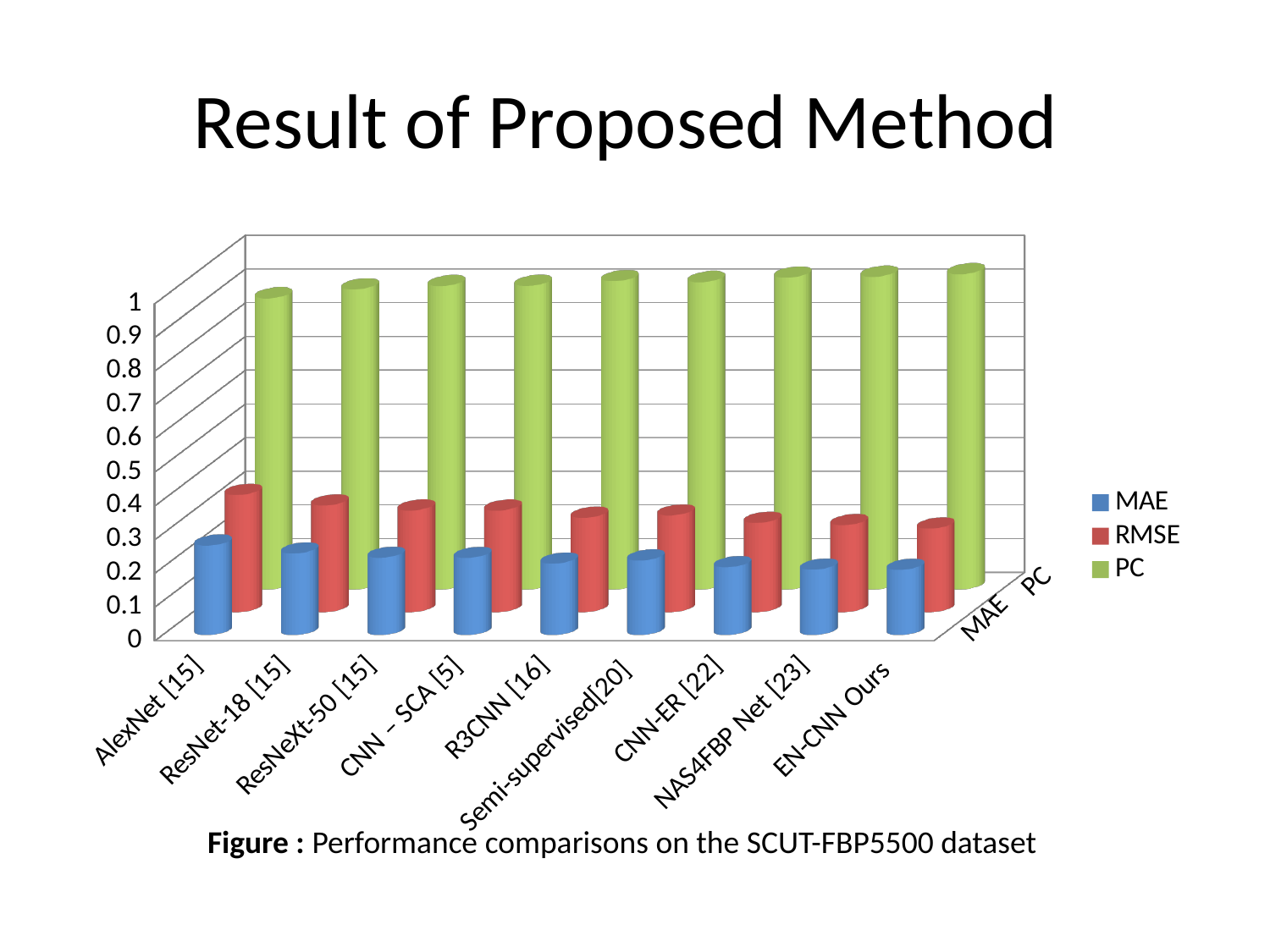
Is the MAE value for AlexNet [15] greater or less than 0.5? less Which series is drawn in green? PC What kind of chart is shown on the slide? bar chart How many series does the legend list? 3 Is the PC value for AlexNet [15] greater or less than 0.5? greater For AlexNet [15], which is larger, the MAE or the RMSE? RMSE What are the three series named in the legend? MAE, RMSE, PC How many methods (categories) are plotted along the x axis? 9 Is the MAE value for EN-CNN Ours greater or less than 0.5? less Which method has the highest MAE? AlexNet [15] For EN-CNN Ours, which is larger, the PC or the MAE? PC Do the MAE values rise or fall moving from AlexNet [15] to EN-CNN Ours along the x axis? fall